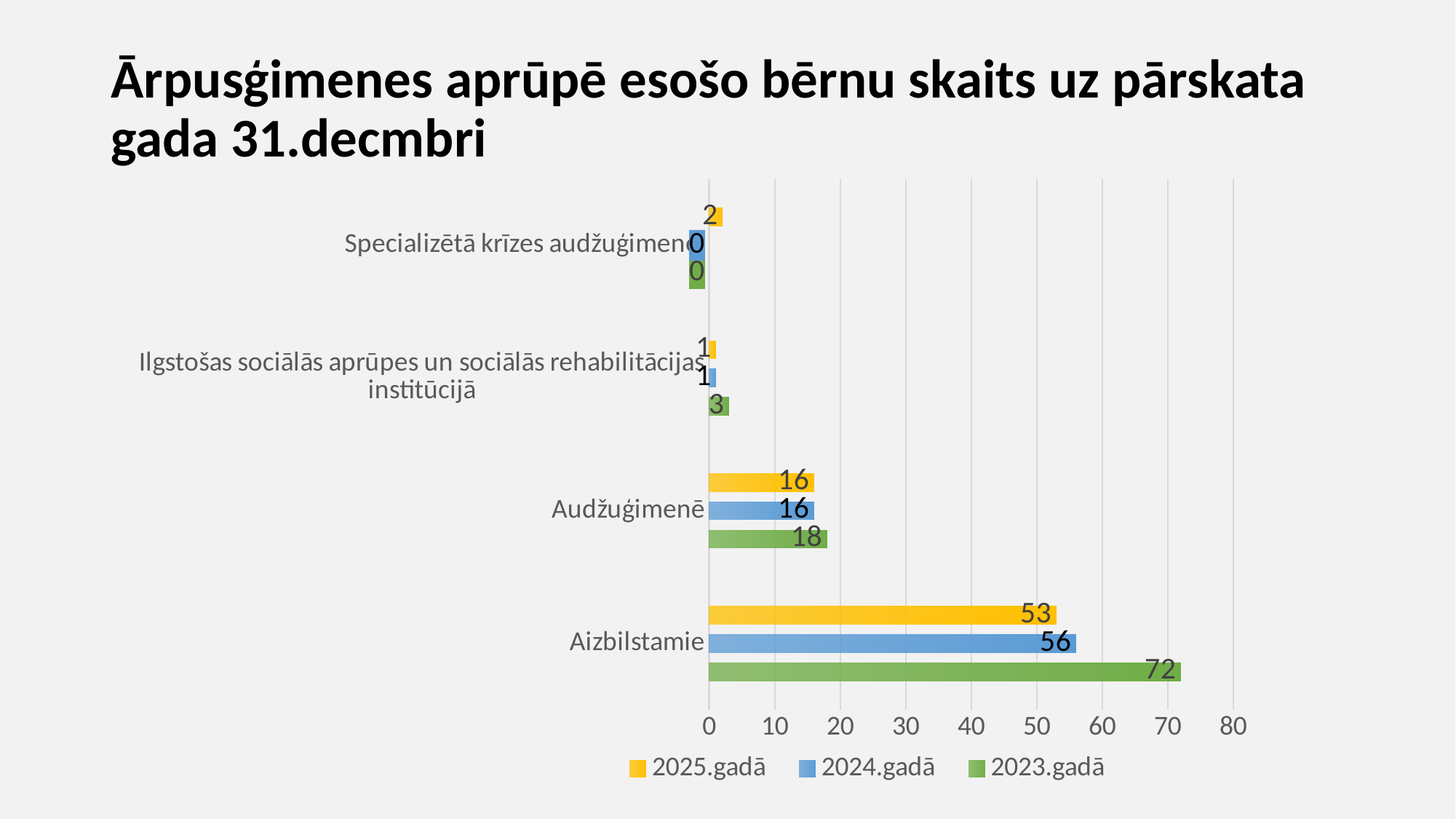
What is the difference between the 2023.gadā and 2025.gadā values for Aizbilstamie? 19 How many categories are shown on the chart? 4 Which is larger for Aizbilstamie: the 2024.gadā value or the 2025.gadā value? 2024.gadā What is the value for Audžuģimenē in 2025.gadā? 16 What is the value for Aizbilstamie in 2023.gadā? 72 What kind of chart is shown on the slide? bar chart Is the value for Aizbilstamie in 2023.gadā greater or less than 70? greater What is the value for Ilgstošas sociālās aprūpes un sociālās rehabilitācijas institūcijā in 2023.gadā? 3 What is the value for Specializētā krīzes audžuģimenē in 2025.gadā? 2 Which colour represents 2023.gadā in the legend? green Which category has the highest value in 2024.gadā? Aizbilstamie How many series does the legend list? 3